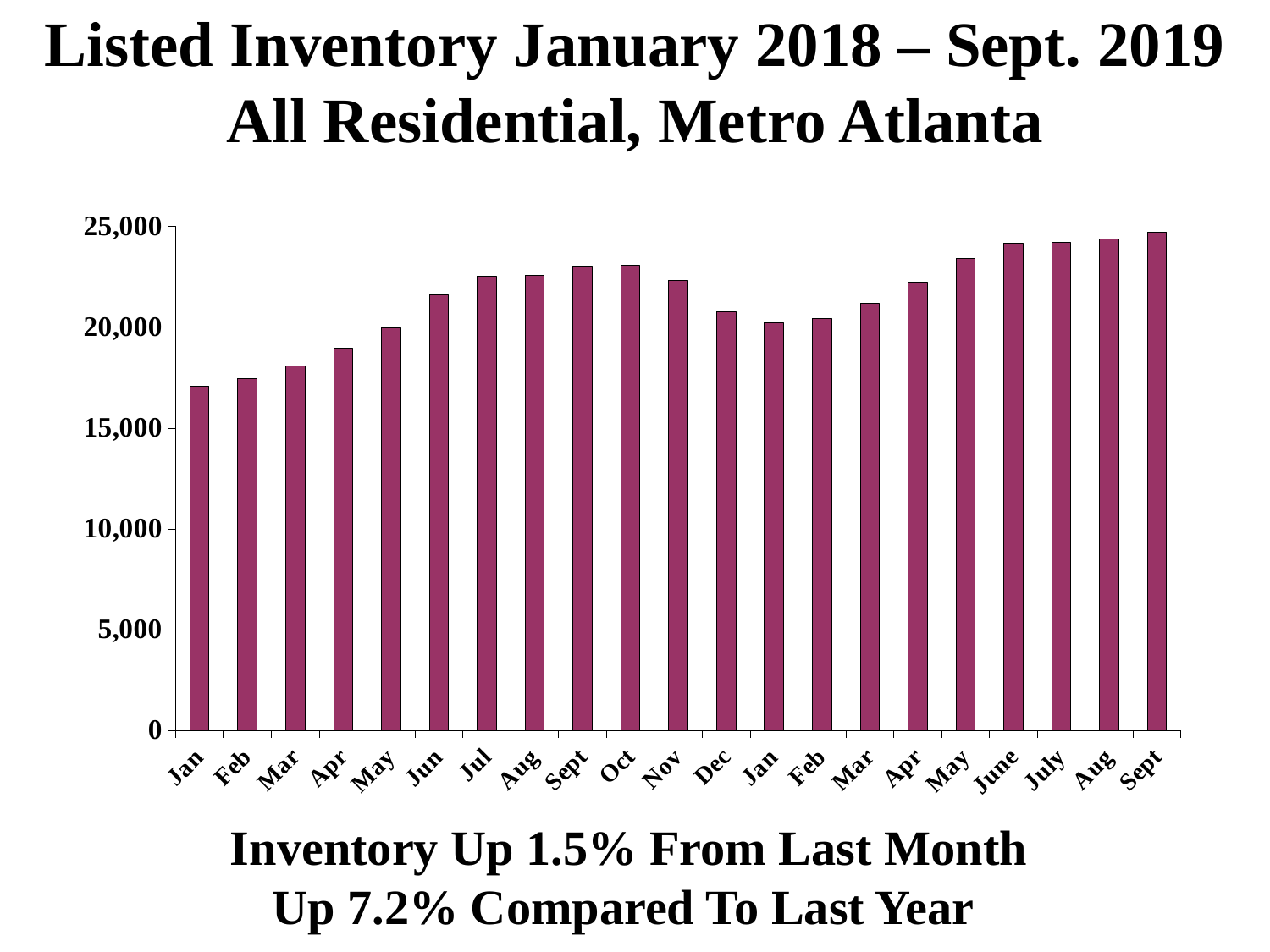
Is the value for Jan 2018 (the first bar) greater or less than 20,000? less Is the value for Mar 2018 greater or less than 20,000? less What kind of chart is shown on the slide? bar chart Which month has the lowest listed inventory in the chart? Jan (2018) Which is larger, the value for Oct 2018 or the value for Dec 2018? Oct 2018 Which is larger, the value for Jan 2019 or the value for May 2019? May 2019 Is the value for Sept 2019 (the last bar) greater or less than 25,000? less Which month has the highest listed inventory in the chart? Sept (2019) How many bars (months) are plotted in the chart? 21 According to the text below the chart, by what percentage is inventory up compared to last year? 7.2% Overall, do the values rise or fall from Jan 2018 to Sept 2019? rise